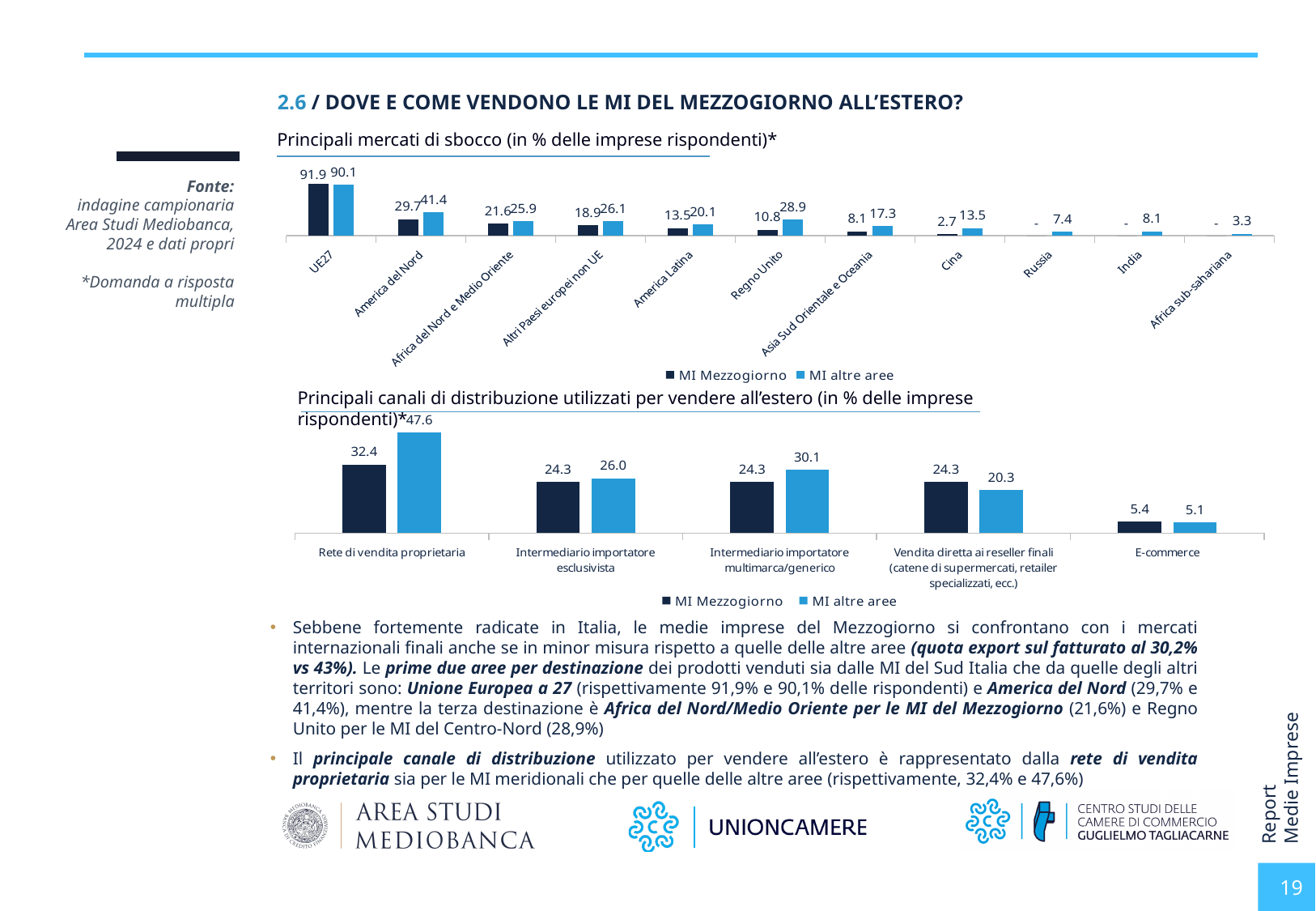
In the 'Principali canali di distribuzione' chart, which is larger for Vendita diretta ai reseller finali: MI Mezzogiorno or MI altre aree? MI Mezzogiorno What type of chart is the 'Principali canali di distribuzione' chart? Bar chart In the 'Principali canali di distribuzione' chart, what is the value for E-commerce in the MI Mezzogiorno series? 5.4 In the 'Principali mercati di sbocco' chart, what is the value for Regno Unito in the MI altre aree series? 28.9 In the 'Principali mercati di sbocco' chart, what is the value for UE27 in the MI Mezzogiorno series? 91.9 In the 'Principali canali di distribuzione' chart, what is the value for Rete di vendita proprietaria in the MI altre aree series? 47.6 In the 'Principali canali di distribuzione' chart, what is the difference between the MI altre aree and MI Mezzogiorno values for Intermediario importatore multimarca/generico? 5.8 In the 'Principali mercati di sbocco' chart, which category has the lowest value for MI altre aree? Africa sub-sahariana In the 'Principali mercati di sbocco' chart, how many categories are shown on the x axis? 11 In the 'Principali mercati di sbocco' chart, what is the difference between the MI altre aree and MI Mezzogiorno values for America del Nord? 11.7 In the 'Principali mercati di sbocco' chart, which category has the highest value for MI altre aree? UE27 How many series does the legend of the 'Principali canali di distribuzione' chart list? 2